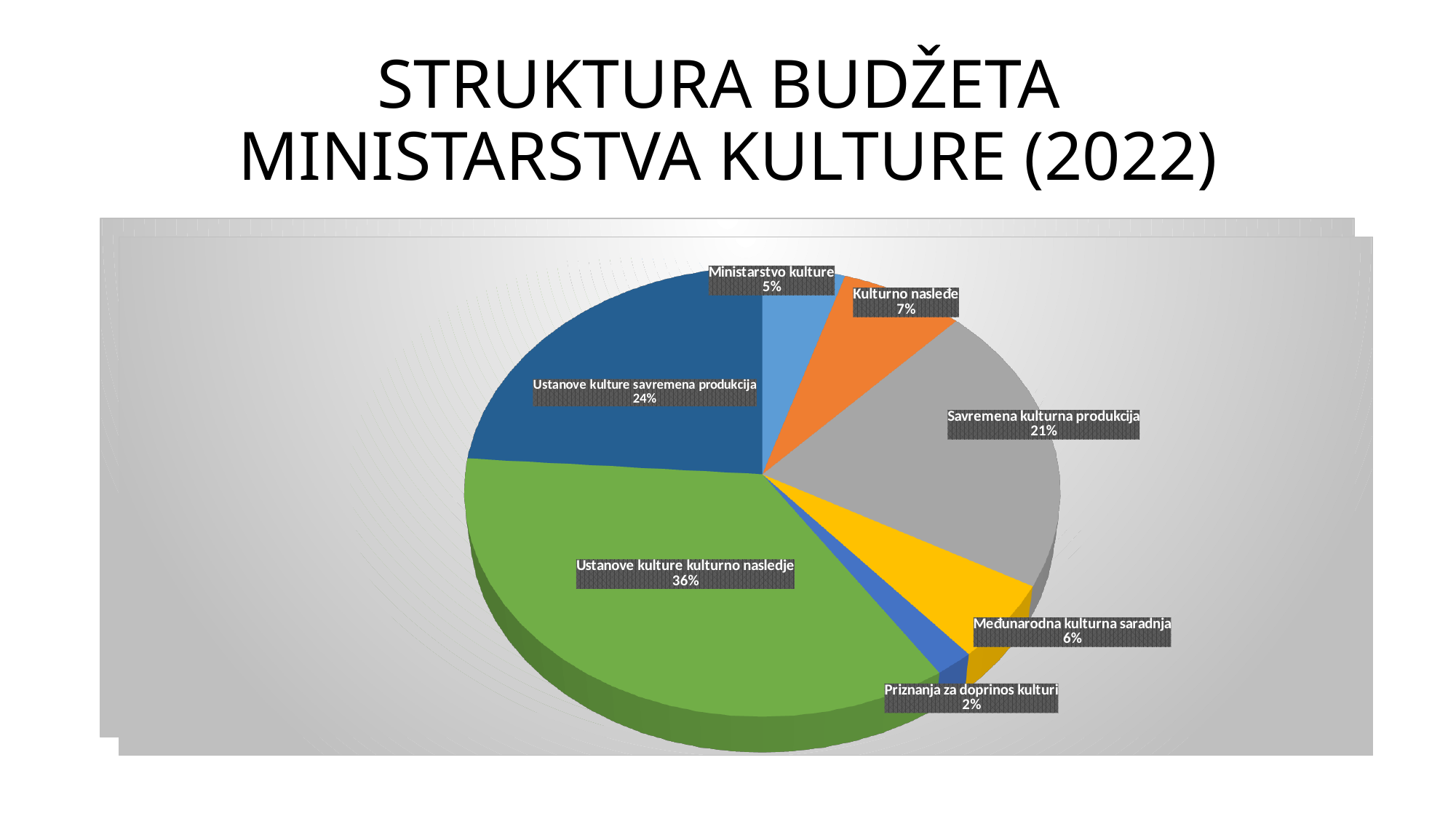
Which category has the smallest slice of the pie? Priznanja za doprinos kulturi What share of the budget goes to Ustanove kulture kulturno nasledje? 36% What percentage is labelled for Priznanja za doprinos kulturi? 2% What is the difference in percentage points between Ustanove kulture kulturno nasledje and Ustanove kulture savremena produkcija? 12 What percentage is shown for Savremena kulturna produkcija? 21% What type of chart is shown on the slide? Pie chart What is the value for Ministarstvo kulture? 5% Which is larger, Kulturno nasleđe or Međunarodna kulturna saradnja? Kulturno nasleđe What is the combined share of Ustanove kulture kulturno nasledje and Ustanove kulture savremena produkcija? 60% Which category has the largest slice of the pie? Ustanove kulture kulturno nasledje How many slices does the pie chart have? 7 What is the title of the slide? STRUKTURA BUDŽETA MINISTARSTVA KULTURE (2022)